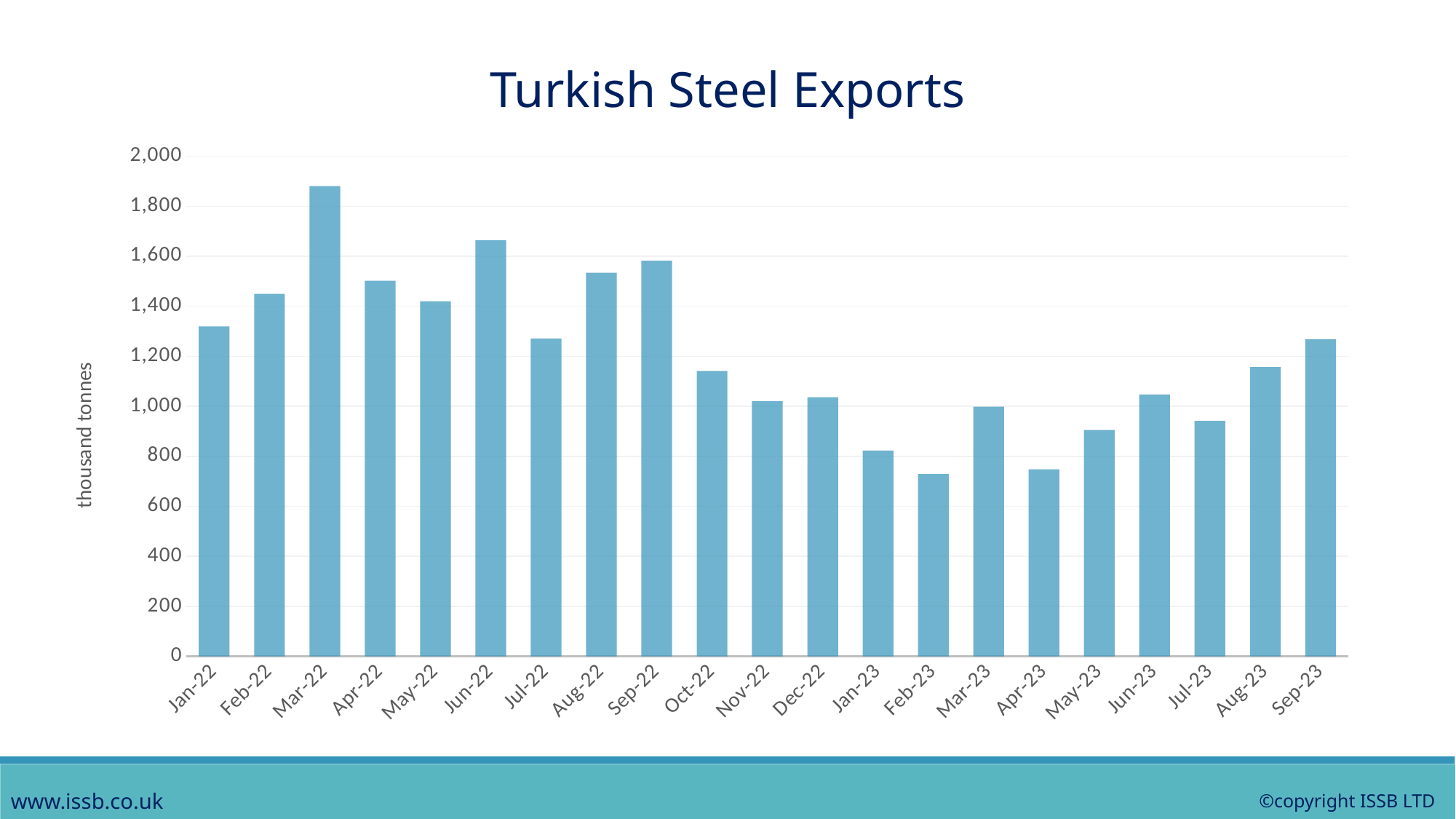
What unit is shown on the vertical axis label? thousand tonnes Which is larger, the value for Aug-23 or the value for Sep-23? Sep-23 Is the value for Jun-22 greater or less than 1,600? greater How many months are plotted on the chart? 21 Do the values generally rise or fall from Mar-22 to Feb-23? fall Which month has the highest value? Mar-22 Is the value for Oct-22 greater or less than 1,200? less Is the value for Feb-23 greater or less than 800? less What kind of chart is shown on the slide? bar chart Which is larger, the value for Jun-22 or the value for Sep-22? Jun-22 What is the title of the chart? Turkish Steel Exports